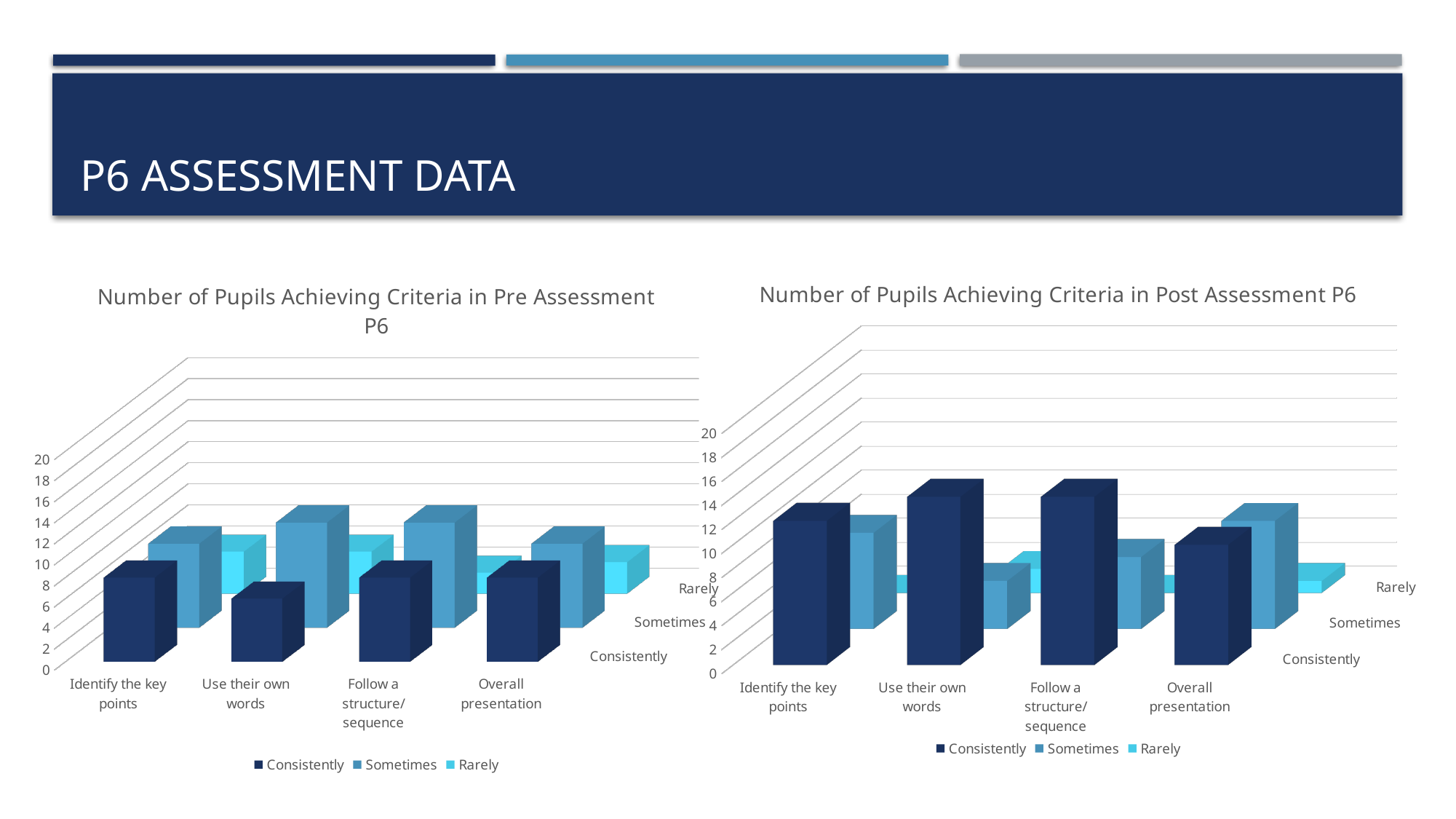
In the 'Number of Pupils Achieving Criteria in Post Assessment P6' chart, which category has the lowest value for the Consistently series? Overall presentation What is the title of the chart on the left of the slide? Number of Pupils Achieving Criteria in Pre Assessment P6 In the 'Number of Pupils Achieving Criteria in Post Assessment P6' chart, for 'Use their own words', which series has the larger value: Consistently or Sometimes? Consistently In the 'Number of Pupils Achieving Criteria in Post Assessment P6' chart, is the Consistently value for 'Use their own words' greater or less than 10? greater How many series does the legend list on the 'Number of Pupils Achieving Criteria in Post Assessment P6' chart? 3 In the 'Number of Pupils Achieving Criteria in Pre Assessment P6' chart, which category has the lowest value for the Consistently series? Use their own words What type of chart is the 'Number of Pupils Achieving Criteria in Pre Assessment P6' chart? Bar chart In the 'Number of Pupils Achieving Criteria in Pre Assessment P6' chart, is the Consistently value for 'Use their own words' greater or less than 10? less In the 'Number of Pupils Achieving Criteria in Post Assessment P6' chart, which is larger for the Consistently series: 'Identify the key points' or 'Overall presentation'? Identify the key points How many criteria categories are shown on the x axis of the 'Number of Pupils Achieving Criteria in Pre Assessment P6' chart? 4 What are the legend entries on the 'Number of Pupils Achieving Criteria in Post Assessment P6' chart? Consistently, Sometimes, Rarely